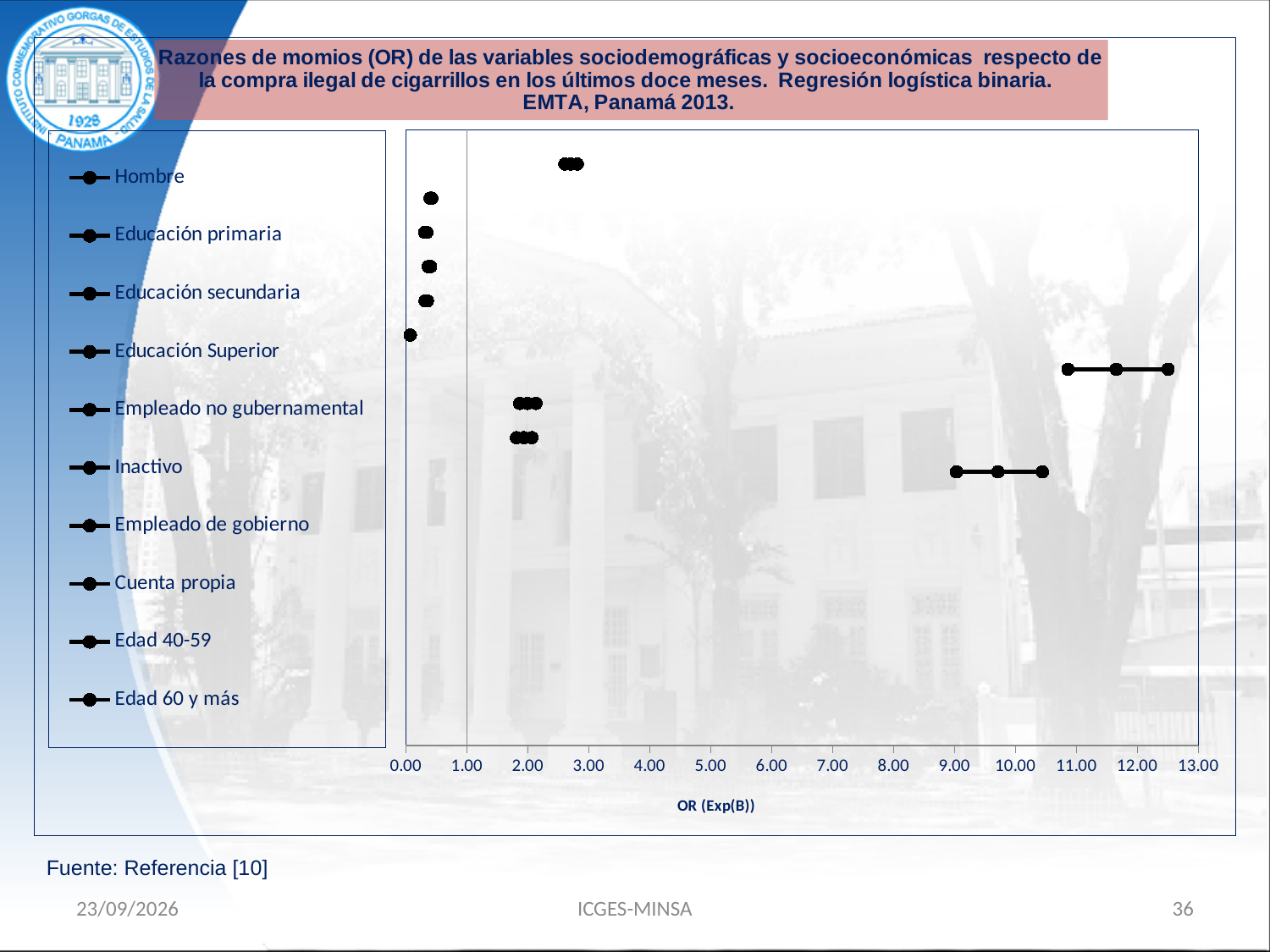
Is the rightmost plotted point on the chart greater or less than 12.00? greater Is the topmost plotted point on the chart greater or less than 2.00? greater What is the title of the horizontal axis? OR (Exp(B)) Is the lowest plotted point on the chart (the one nearest the bottom) greater or less than 8.00? greater What is the highest value shown on the horizontal axis? 13.00 What kind of chart is shown on the slide? scatter chart How many series does the legend list? 10 Which legend entry is listed first in the legend? Hombre